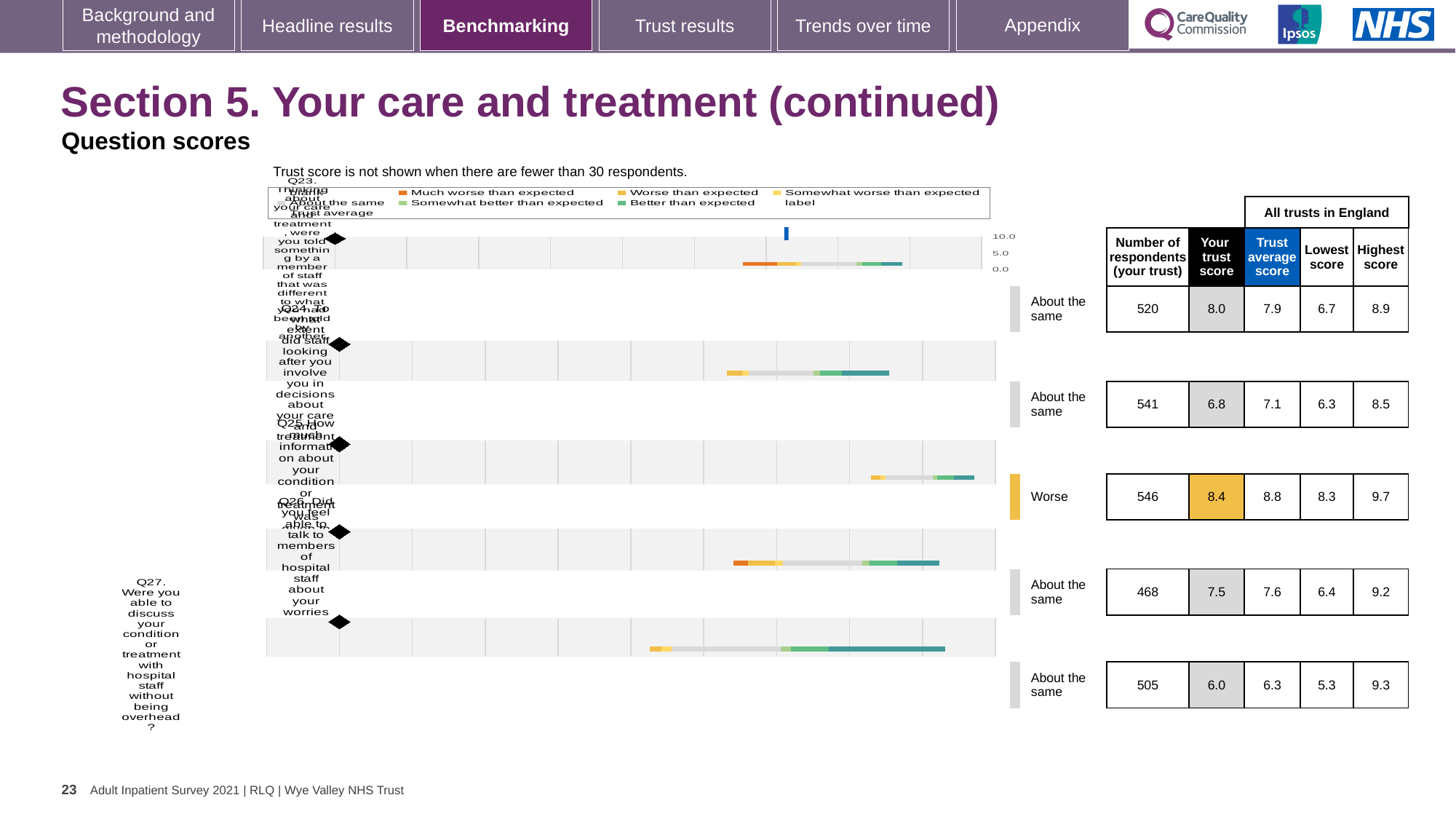
Which question has the lowest trust score on this slide? Q27 What kind of chart is used to show the question scores? Bar chart What is the highest score across all trusts in England for Q24 (involving you in decisions about your care and treatment)? 8.5 Which question has the highest trust score on this slide? Q25 What is the lowest score across all trusts in England for Q26 (talking to hospital staff about your worries)? 6.4 What is the difference between the trust average score and the trust score for Q25? 0.4 For Q27, what is the difference between the highest score and the lowest score across all trusts in England? 4.0 How many questions are shown on this slide? 5 Which question is rated 'Worse' compared with other trusts? Q25 For Q23, which is larger: the trust score or the trust average score? Trust score What is the trust score for Q27 (discussing your condition or treatment without being overheard)? 6.0 How many respondents answered Q25 (how much information about your condition or treatment was given to you)? 546